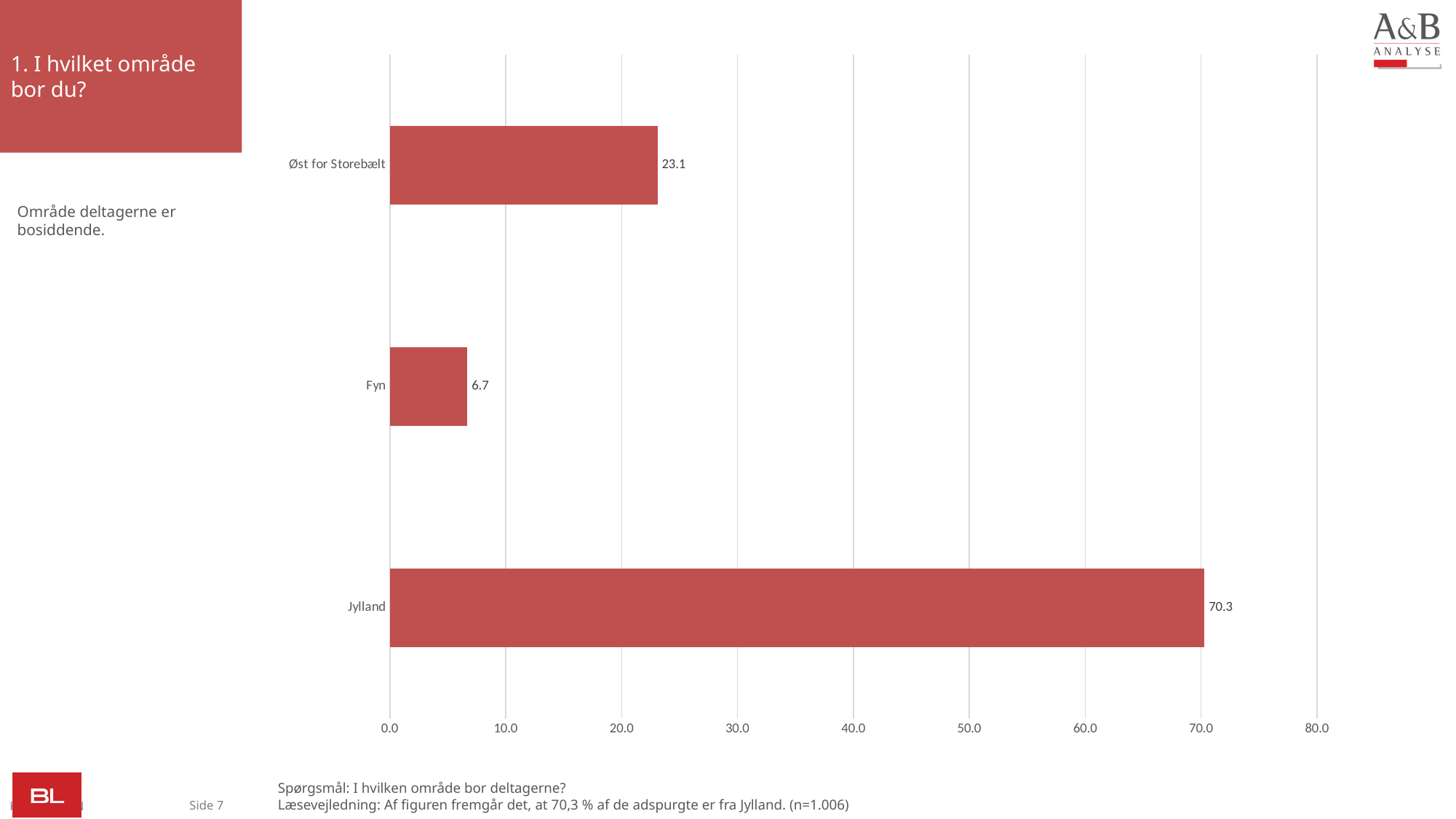
What is the highest tick value shown on the horizontal axis? 80.0 What is the value for Fyn? 6.7 What is the value for Øst for Storebælt? 23.1 What is the value for Jylland? 70.3 What kind of chart is shown on the slide? bar chart Which category has the highest value? Jylland Is the value for Jylland greater or less than 60.0? greater What is the difference between the values for Jylland and Øst for Storebælt? 47.2 What is the difference between the values for Øst for Storebælt and Fyn? 16.4 How many categories are shown in the chart? 3 Which category has the lowest value? Fyn Which is larger, the value for Fyn or the value for Øst for Storebælt? Øst for Storebælt